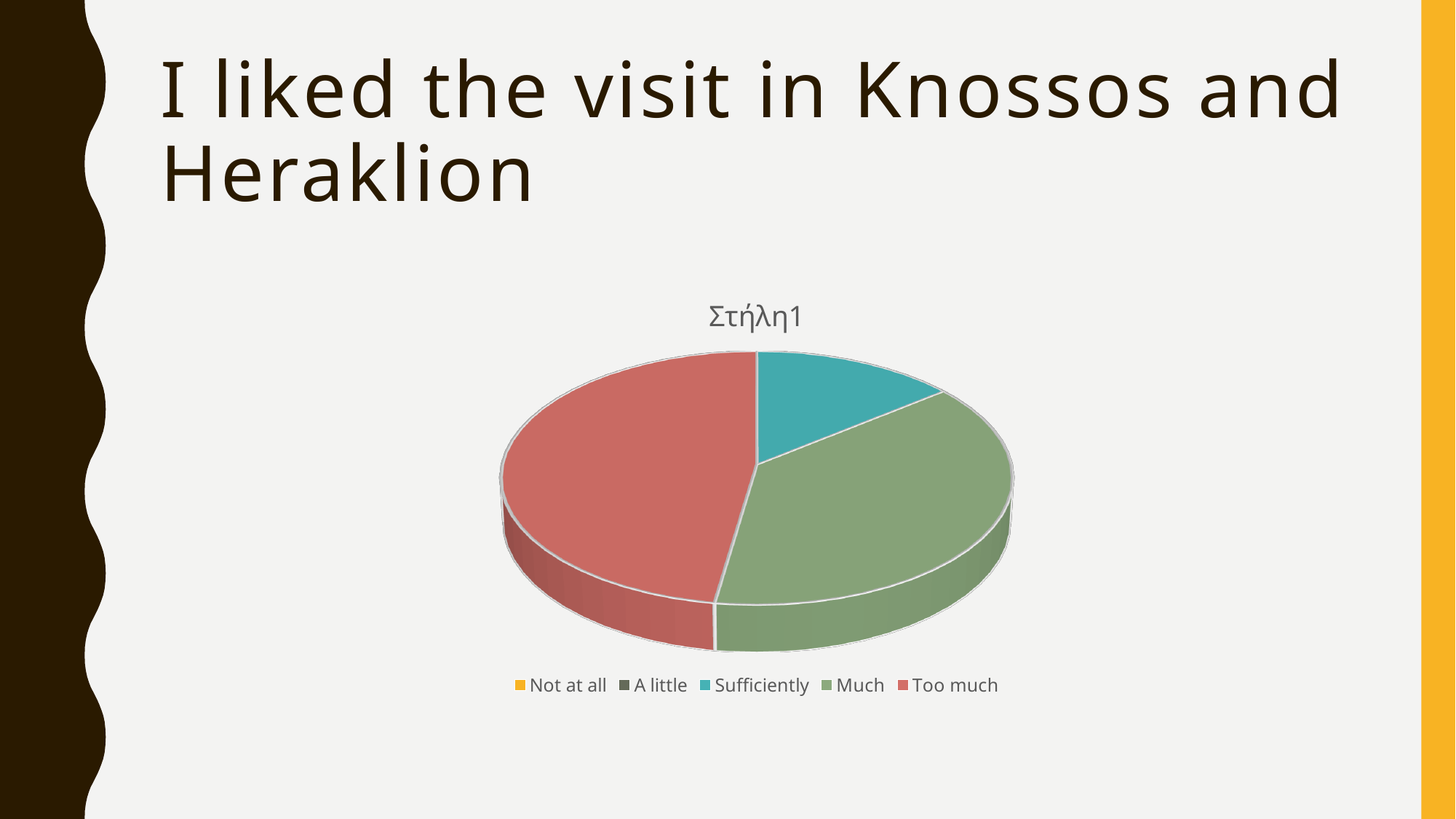
Which slice is larger, Too much or Much? Too much How many slices are visible in the pie? 3 What kind of chart is shown on the slide? Pie chart Which slice is larger, Much or Sufficiently? Much Which category has the largest slice of the pie? Too much What is the title shown above the pie chart? Στήλη1 What colour is the Too much slice? Red Which slice is larger, Too much or Sufficiently? Too much Which of the slices visible in the pie is the smallest? Sufficiently How many categories does the legend list? 5